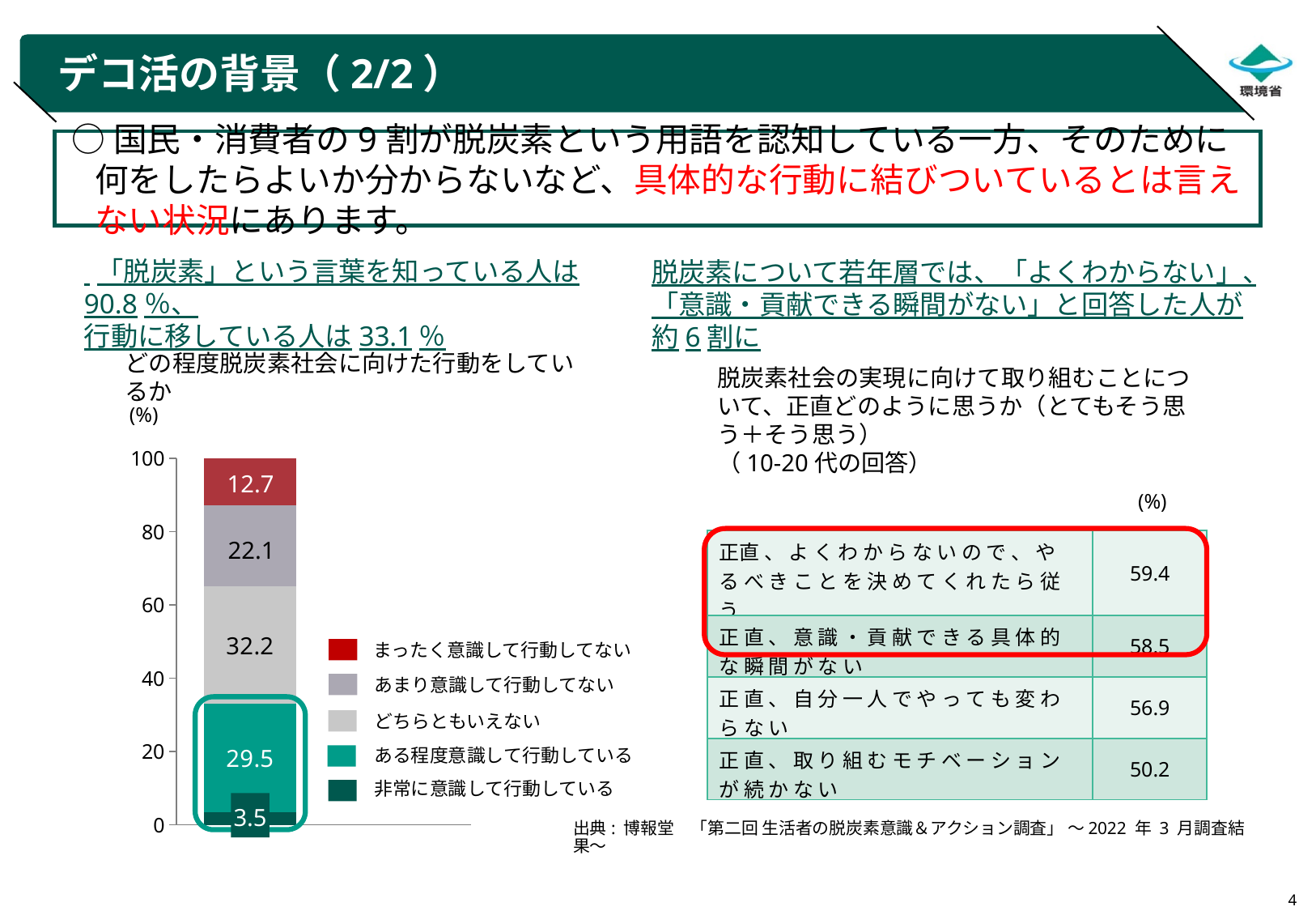
In the stacked bar chart, what is the value for 「非常に意識して行動している」? 3.5 In the stacked bar chart, what is the value for 「ある程度意識して行動している」? 29.5 In the stacked bar chart, what is the value for 「まったく意識して行動してない」? 12.7 What is the total of all segments in the stacked bar? 100.0 How many series does the legend of the stacked bar chart list? 5 In the stacked bar chart, what is the difference between 「あまり意識して行動してない」 and 「まったく意識して行動してない」? 9.4 What kind of chart is shown on the left of the slide? Stacked bar chart In the stacked bar chart, which segment has the smallest value? 非常に意識して行動している In the stacked bar chart, what is the value for 「あまり意識して行動してない」? 22.1 In the stacked bar chart, which segment has the largest value? どちらともいえない In the stacked bar chart, which is larger: 「どちらともいえない」 or 「ある程度意識して行動している」? どちらともいえない In the stacked bar chart, what is the value for 「どちらともいえない」? 32.2